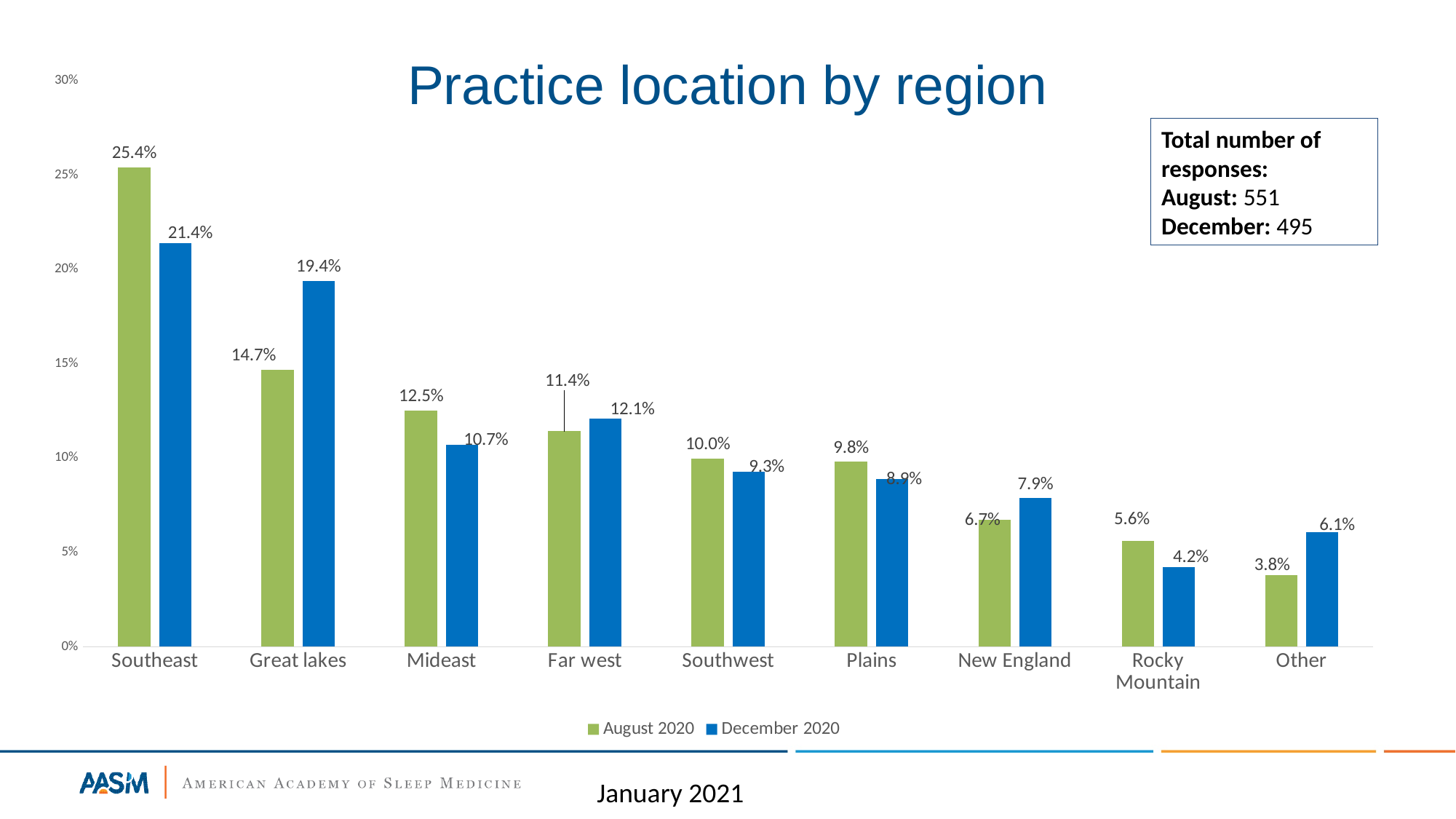
What is the difference between the August 2020 and December 2020 values for Great lakes? 4.7% How many series does the legend list? 2 What is the August 2020 value for Southeast? 25.4% Which region has the lowest August 2020 value? Other Which region has the highest December 2020 value? Southeast What kind of chart is shown on the slide? Bar chart Is the December 2020 value for Far west greater or less than 10%? greater What is the December 2020 value for Great lakes? 19.4% Which is larger for Mideast: the August 2020 value or the December 2020 value? August 2020 How many regions are shown on the x axis? 9 What is the title of the chart? Practice location by region What is the December 2020 value for Rocky Mountain? 4.2%